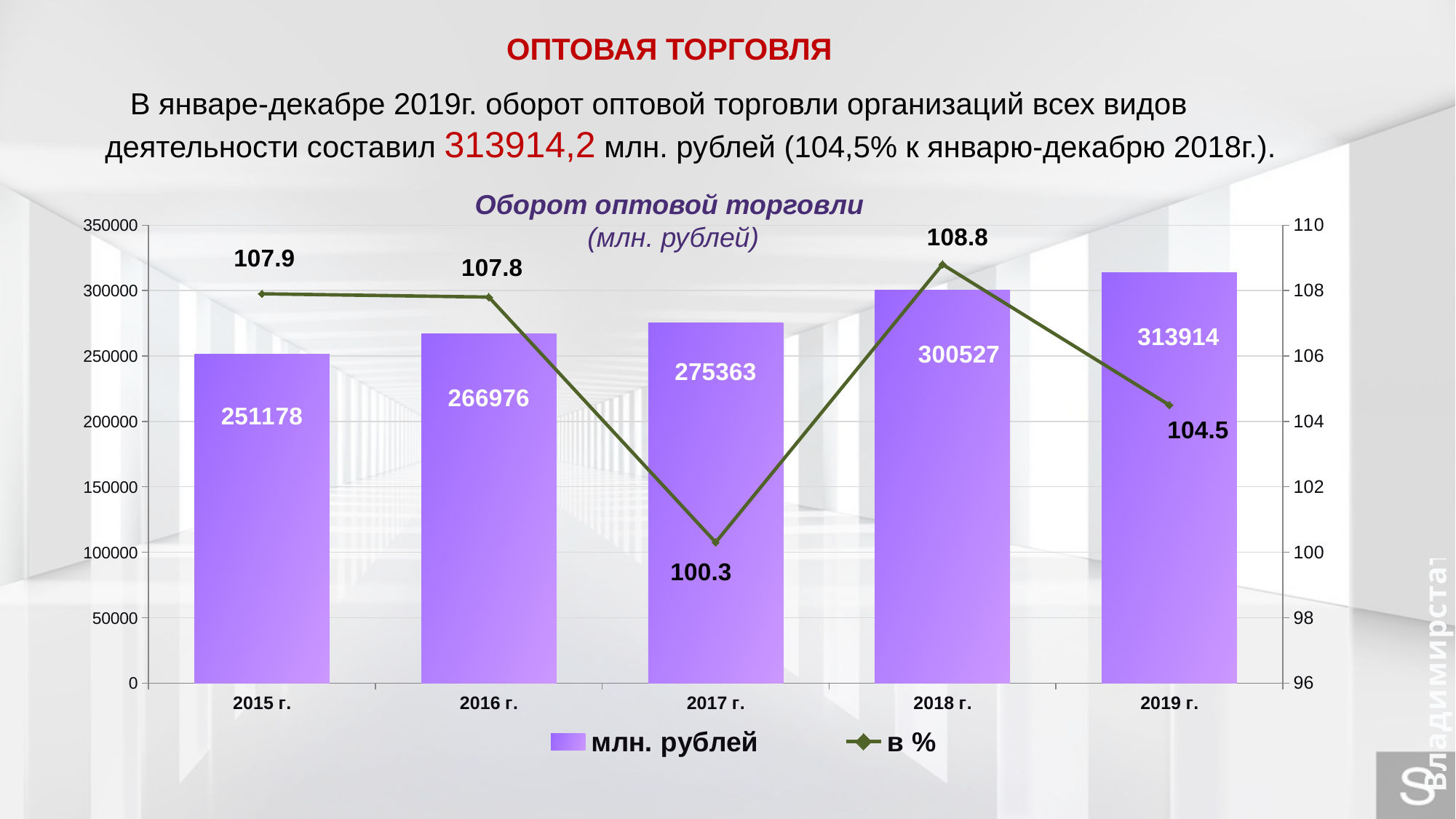
Do the "млн. рублей" values rise or fall from 2015 г. to 2019 г.? Rise What is the value of the "млн. рублей" series for 2015 г.? 251178 What is the value of the "в %" series for 2018 г.? 108.8 What is the title of the chart? Оборот оптовой торговли (млн. рублей) What is the difference between the "млн. рублей" values for 2019 г. and 2018 г.? 13387 What is the value of the "млн. рублей" series for 2017 г.? 275363 Which is larger: the "в %" value for 2015 г. or for 2019 г.? 2015 г. How many series does the legend list? 2 What kind of chart is this? Combined bar and line chart Which year has the highest value in the "млн. рублей" series? 2019 г. Which year has the lowest value in the "в %" series? 2017 г. How many years are shown on the x axis? 5